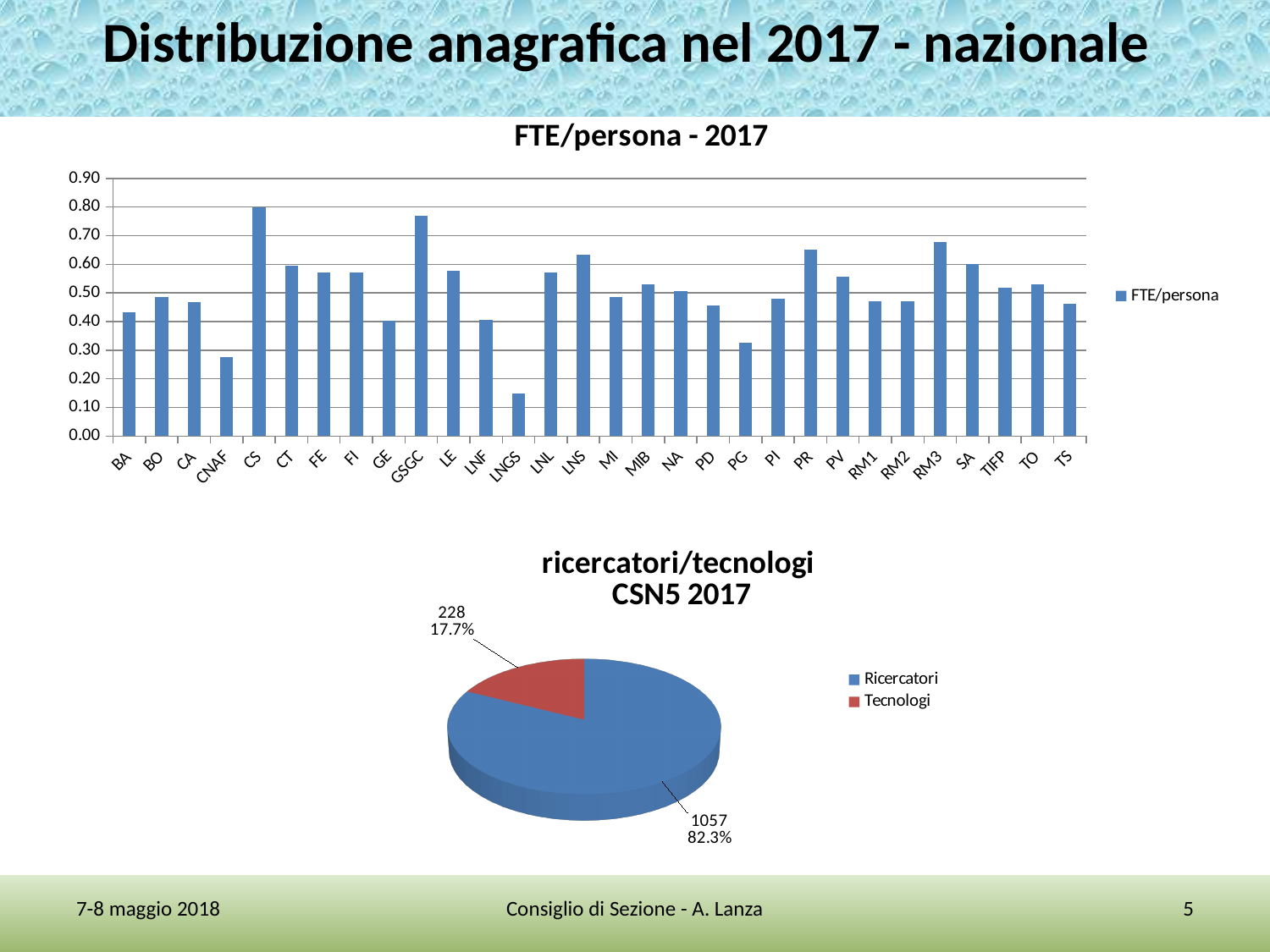
In the FTE/persona - 2017 chart, how many series does the legend list? 1 In the FTE/persona - 2017 chart, is the value for RM3 greater or less than 0.60? greater In the ricercatori/tecnologi CSN5 2017 pie chart, what is the difference between the Ricercatori and Tecnologi values? 829 In the ricercatori/tecnologi CSN5 2017 pie chart, what is the value for Ricercatori? 1057 In the FTE/persona - 2017 chart, which is larger, the value for CS or the value for CNAF? CS In the FTE/persona - 2017 chart, how many categories are shown on the x axis? 30 In the FTE/persona - 2017 chart, is the value for CNAF greater or less than 0.30? less In the FTE/persona - 2017 chart, which category has the lowest value? LNGS In the FTE/persona - 2017 chart, is the value for LNGS greater or less than 0.20? less In the ricercatori/tecnologi CSN5 2017 pie chart, what share of the pie is Tecnologi? 17.7% In the FTE/persona - 2017 chart, what kind of chart is it? bar chart